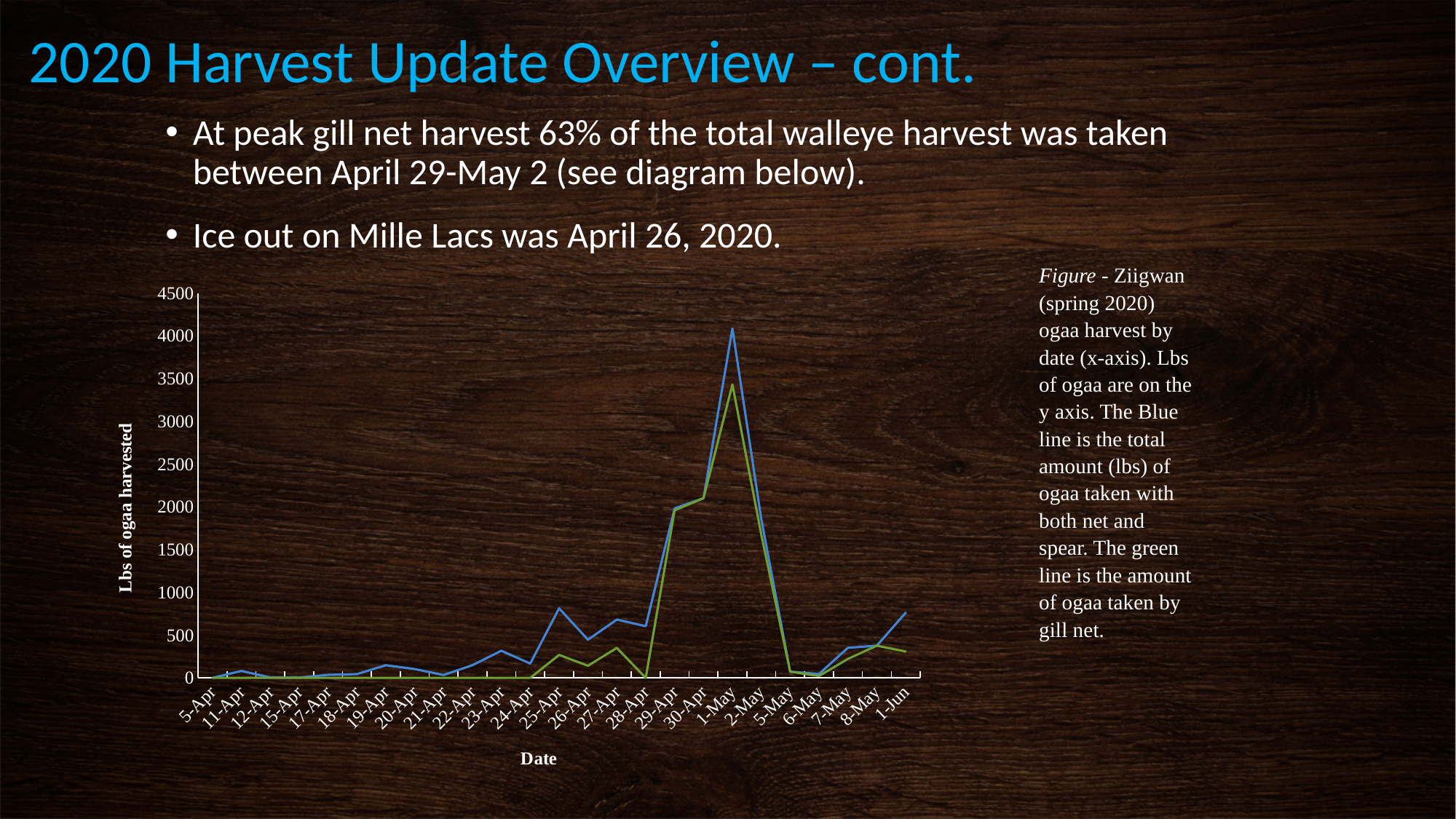
On 25-Apr, which line has the larger value, the blue line or the green line? blue line How many dates are shown along the x axis of the chart? 25 Is the value of the blue line on 29-Apr greater or less than 1500? greater Is the value of the green line on 1-May greater or less than 3000? greater What is the title of the y axis of the chart? Lbs of ogaa harvested Is the value of the green line on 28-Apr greater or less than 500? less What kind of chart is shown on the slide? line chart Does the blue line rise or fall between 1-May and 5-May? fall On which date does the green line reach its highest value? 1-May On which date does the blue line reach its highest value? 1-May